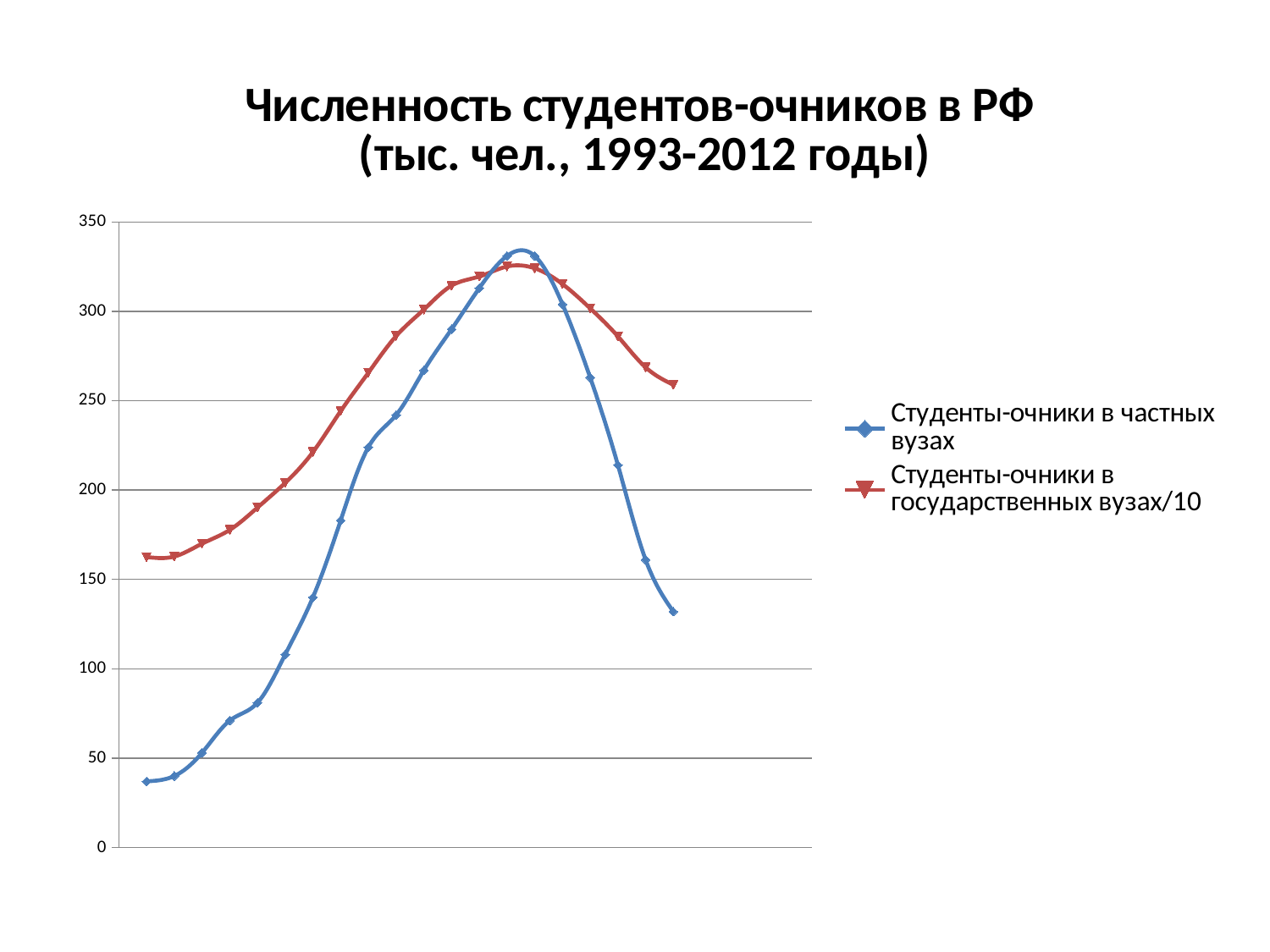
Is the last value of the series 'Студенты-очники в государственных вузах/10' greater or less than 250? greater Is the last value of the series 'Студенты-очники в частных вузах' greater or less than 150? less What kind of chart is shown on the slide? line chart How many series does the legend list? 2 Which series is drawn in red with triangle markers? Студенты-очники в государственных вузах/10 Over the last several points, do the values of the series 'Студенты-очники в частных вузах' rise or fall? fall Is the highest value of the series 'Студенты-очники в частных вузах' greater or less than 300? greater At the end of the period, which series has the larger value: 'Студенты-очники в частных вузах' or 'Студенты-очники в государственных вузах/10'? Студенты-очники в государственных вузах/10 At the start of the period, which series has the larger value: 'Студенты-очники в частных вузах' or 'Студенты-очники в государственных вузах/10'? Студенты-очники в государственных вузах/10 What is the title of the chart? Численность студентов-очников в РФ (тыс. чел., 1993-2012 годы)